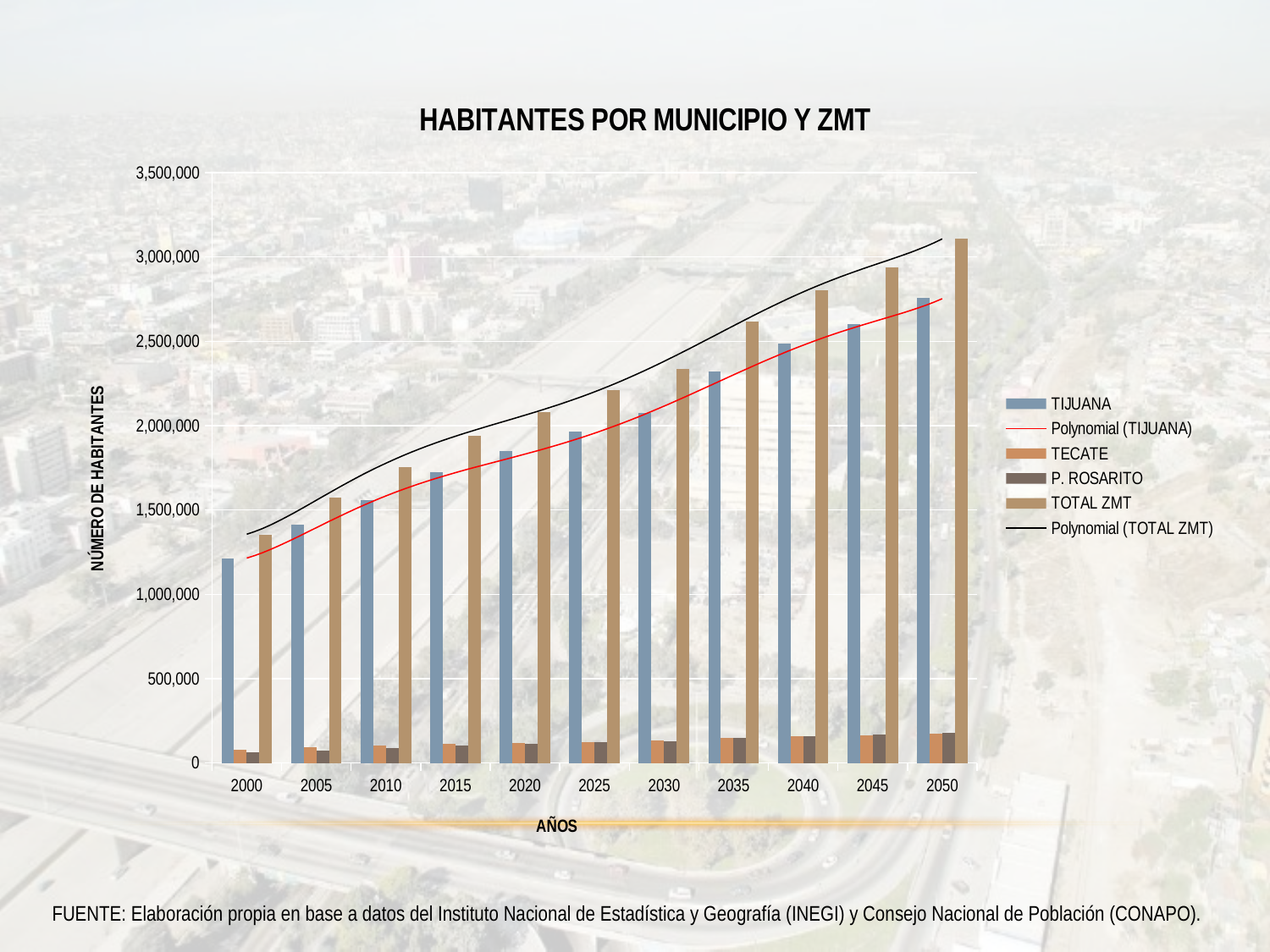
In 2050, which is larger: the TIJUANA bar or the TOTAL ZMT bar? TOTAL ZMT Is the value for TIJUANA in 2050 greater or less than 2,500,000? greater How many entries does the chart's legend list? 6 Do the TOTAL ZMT values rise or fall from 2000 to 2050? Rise In which year is the TIJUANA bar the lowest? 2000 Is the value for TOTAL ZMT in 2050 greater or less than 3,000,000? greater How many years are shown along the x axis? 11 What is the title of the chart? HABITANTES POR MUNICIPIO Y ZMT In which year is the TOTAL ZMT bar the highest? 2050 Is the value for TECATE in 2050 greater or less than 500,000? less What kind of chart is shown on the slide? Bar chart